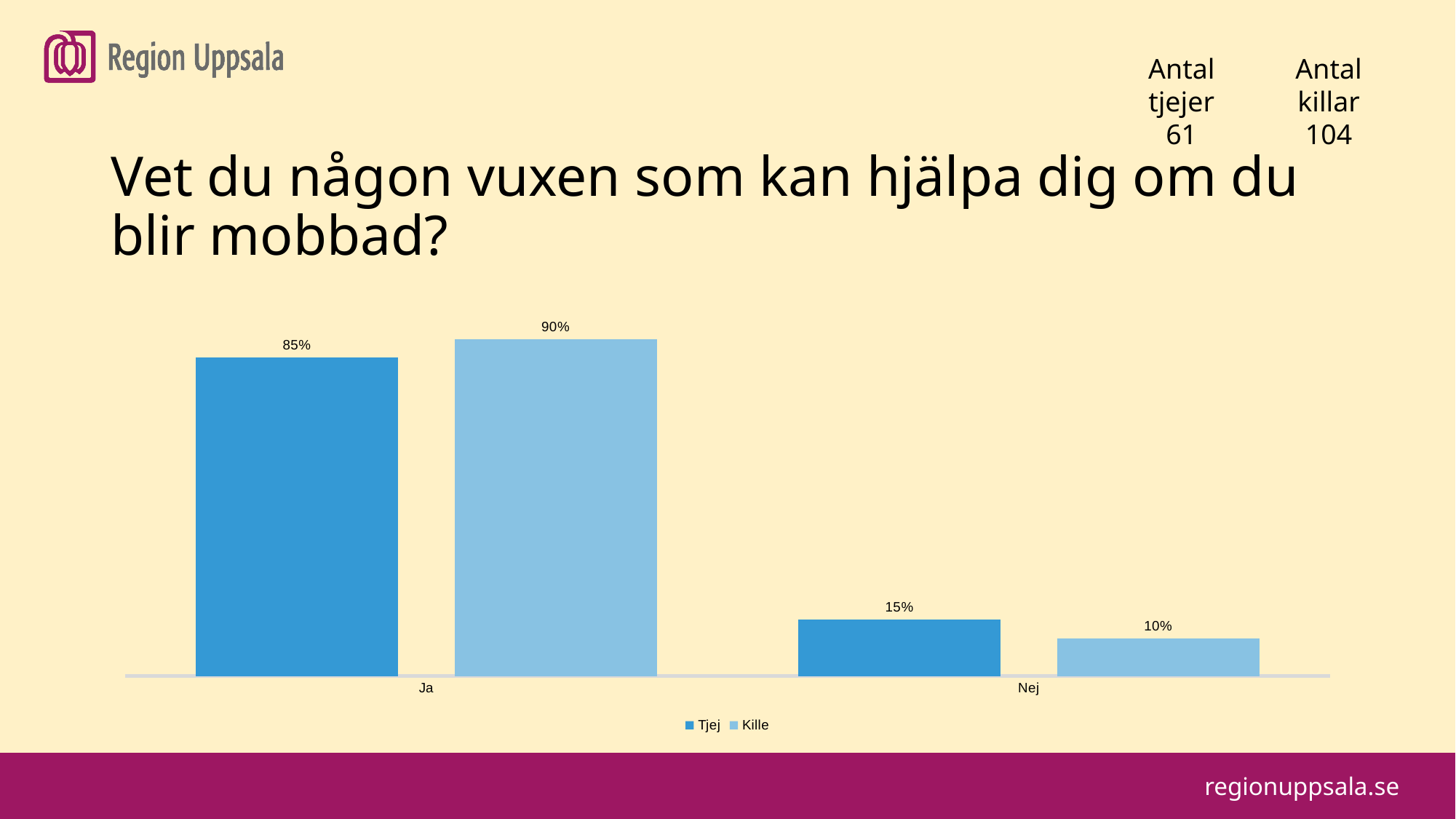
What is the difference between the Tjej and Kille values for Nej? 5% Which bar in the chart is the highest? Kille, Ja Which series has the higher value for Ja, Tjej or Kille? Kille What percentage of Kille answered Nej? 10% What percentage of Kille answered Ja? 90% What kind of chart is shown on the slide? Bar chart Which series has the higher value for Nej, Tjej or Kille? Tjej How many series does the legend list? 2 Which bar in the chart is the lowest? Kille, Nej What percentage of Tjej answered Nej? 15% What is the difference between the Kille and Tjej values for Ja? 5% What percentage of Tjej answered Ja? 85%